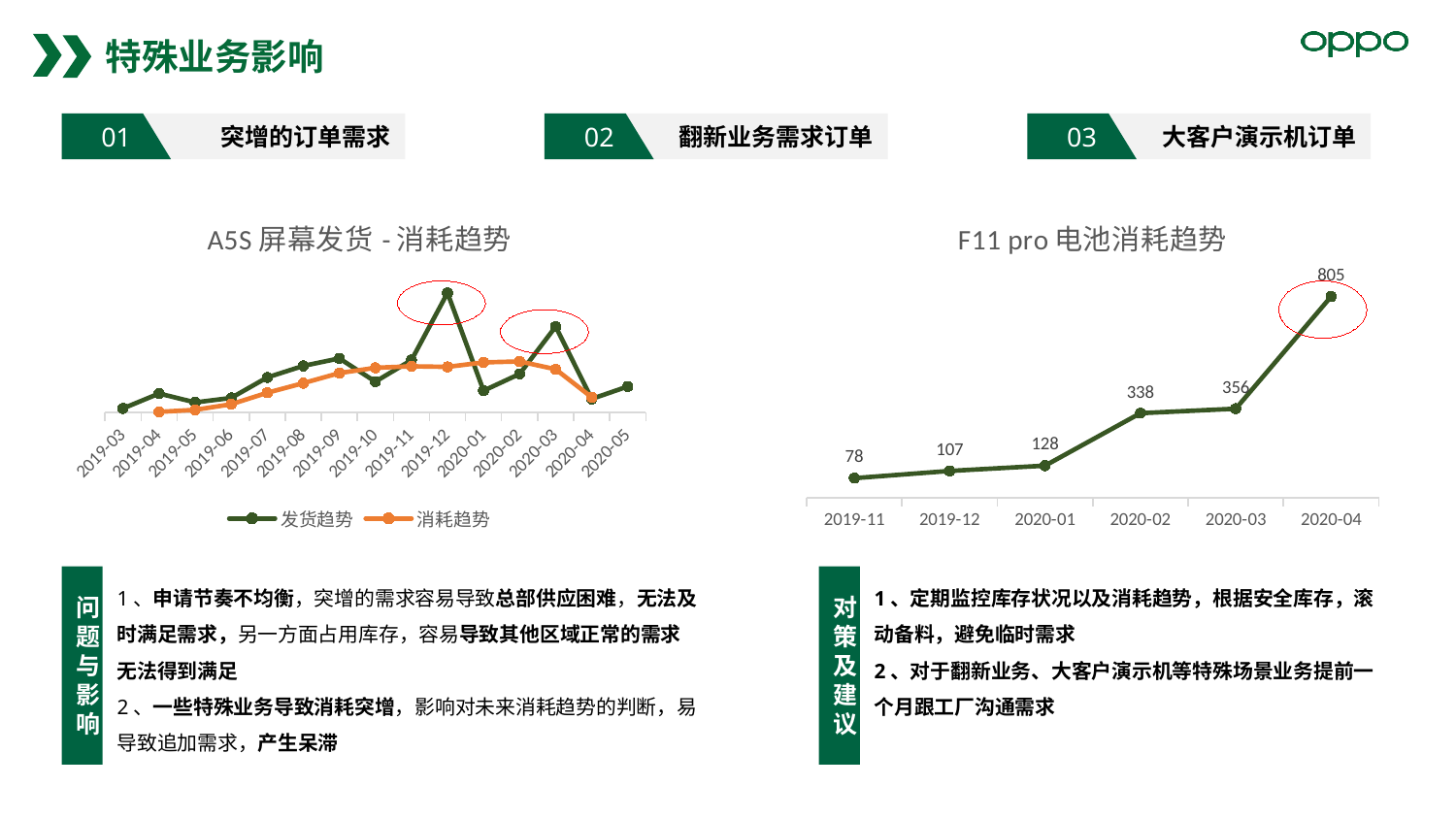
In the F11 pro 电池消耗趋势 chart, what is the value for 2020-02? 338 In the F11 pro 电池消耗趋势 chart, which month has the highest value? 2020-04 What kind of chart is the F11 pro 电池消耗趋势 chart? line chart In the F11 pro 电池消耗趋势 chart, what is the value for 2019-11? 78 How many series does the legend of the A5S 屏幕发货 - 消耗趋势 chart list? 2 In the F11 pro 电池消耗趋势 chart, which is larger, the value for 2019-12 or the value for 2020-01? 2020-01 In the A5S 屏幕发货 - 消耗趋势 chart, how many months are shown on the x axis? 15 In the F11 pro 电池消耗趋势 chart, what is the difference between the values for 2020-04 and 2020-03? 449 In the A5S 屏幕发货 - 消耗趋势 chart, in which month does the 发货趋势 series reach its highest point? 2019-12 In the F11 pro 电池消耗趋势 chart, how many months are plotted? 6 In the F11 pro 电池消耗趋势 chart, do the values rise or fall from 2019-11 to 2020-04? rise In the F11 pro 电池消耗趋势 chart, which month has the lowest value? 2019-11